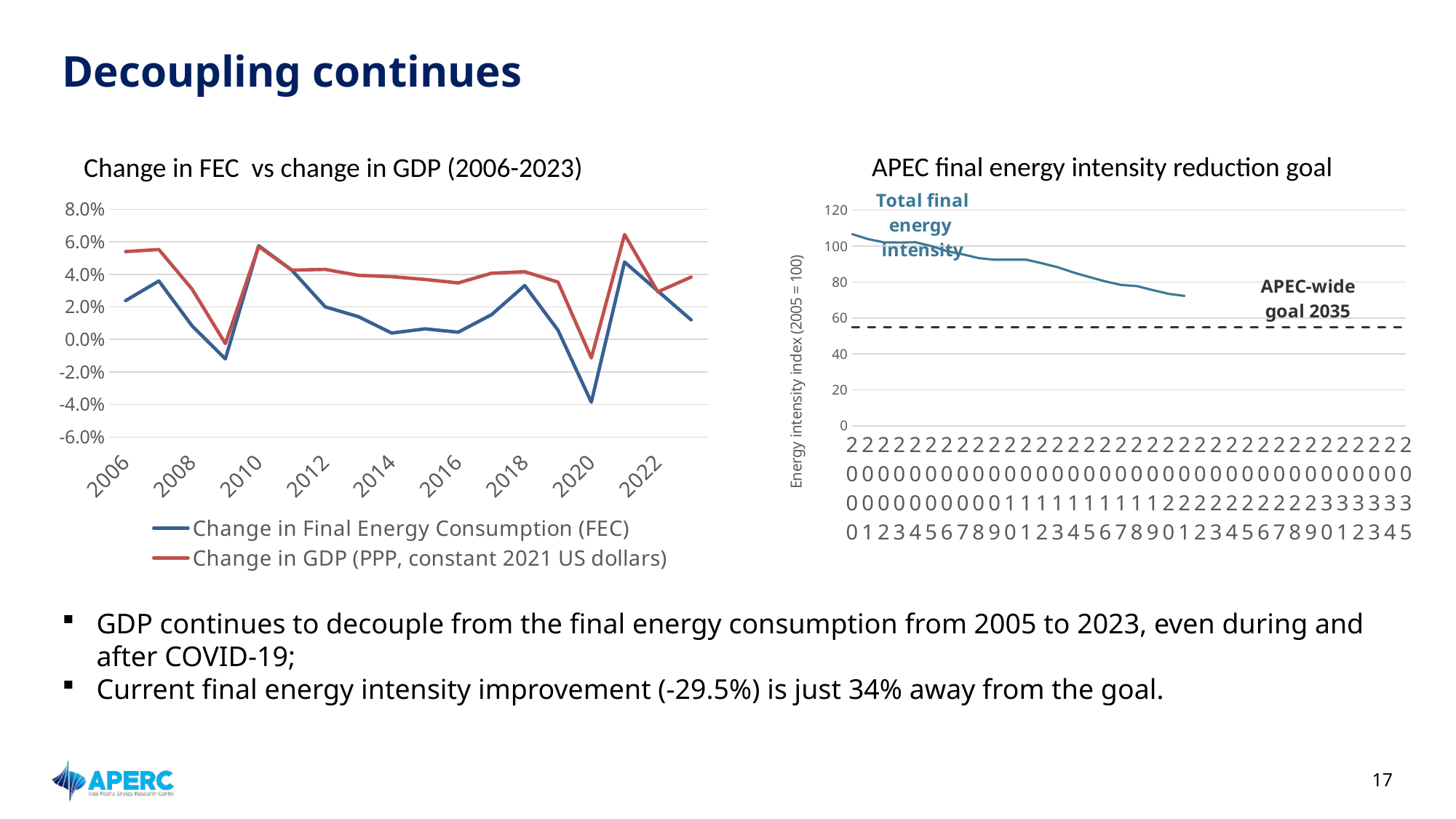
How many series does the legend of the left chart 'Change in FEC vs change in GDP (2006-2023)' list? 2 What is the y-axis label of the right chart 'APEC final energy intensity reduction goal'? Energy intensity index (2005 = 100) In the right chart 'APEC final energy intensity reduction goal', is the dashed APEC-wide goal 2035 line greater or less than 60? less In the left chart 'Change in FEC vs change in GDP (2006-2023)', is the Change in Final Energy Consumption (FEC) value for 2020 greater or less than -2.0%? less What kind of chart is the 'Change in FEC vs change in GDP (2006-2023)' chart on the left? Line chart In the left chart 'Change in FEC vs change in GDP (2006-2023)', what colour is the line for Change in GDP (PPP, constant 2021 US dollars)? Red In the left chart 'Change in FEC vs change in GDP (2006-2023)', which series has the larger value in 2016: Change in Final Energy Consumption (FEC) or Change in GDP? Change in GDP In the left chart 'Change in FEC vs change in GDP (2006-2023)', which year has the lowest value for Change in Final Energy Consumption (FEC)? 2020 In the left chart 'Change in FEC vs change in GDP (2006-2023)', is the Change in GDP value for 2014 greater or less than 2.0%? greater In the left chart 'Change in FEC vs change in GDP (2006-2023)', which year has the highest value for Change in GDP (PPP, constant 2021 US dollars)? 2021